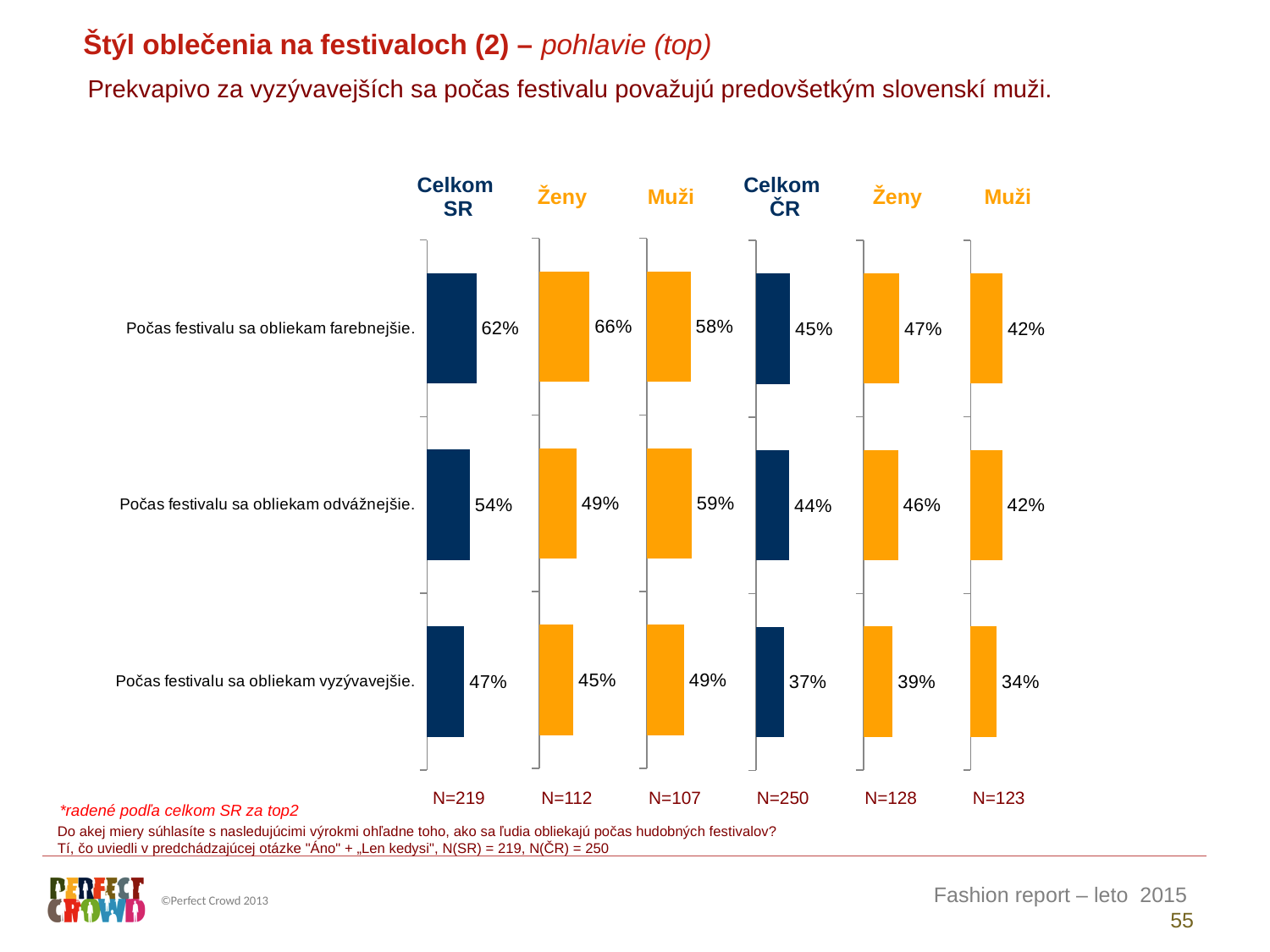
What is the sample size (N) shown under the Celkom ČR chart? N=250 What type of chart is used on this slide? Bar chart In the Ženy chart for SR (second from left), which statement has the highest value? Počas festivalu sa obliekam farebnejšie. For "Počas festivalu sa obliekam vyzývavejšie.", which is larger: the Muži value for SR (third chart) or the Muži value for ČR (rightmost chart)? Muži SR (49%) What is the difference between the Celkom SR value and the Celkom ČR value for "Počas festivalu sa obliekam farebnejšie."? 17 percentage points In the Ženy chart for ČR (fifth from left), what is the value for "Počas festivalu sa obliekam farebnejšie."? 47% In the Muži chart for SR (third from left), what is the value for "Počas festivalu sa obliekam odvážnejšie."? 59% In the Muži chart for ČR (rightmost), what is the value for "Počas festivalu sa obliekam vyzývavejšie."? 34% In the Celkom ČR chart (fourth from left), what is the value for "Počas festivalu sa obliekam vyzývavejšie."? 37% In the Celkom SR chart (leftmost), which statement has the lowest value? Počas festivalu sa obliekam vyzývavejšie. In the Celkom SR chart (leftmost), what is the value for "Počas festivalu sa obliekam farebnejšie."? 62% How many statements (categories) are shown in each chart? 3